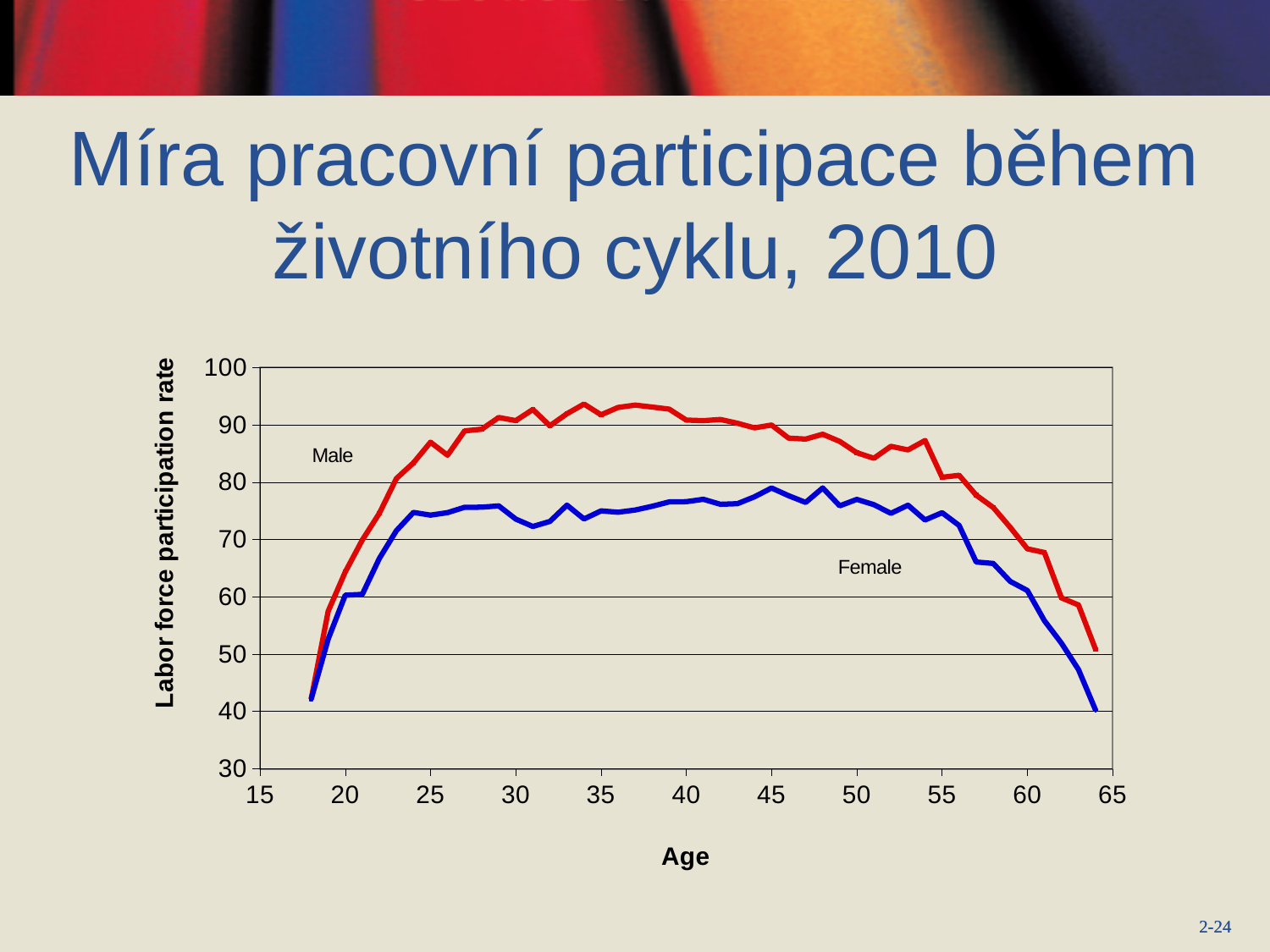
Does the Female series rise or fall between age 55 and age 64? fall What is the label of the x axis? Age How many series are plotted on the chart? 2 Is the value for Female at age 35 greater or less than 80? less Does the Male series rise or fall between age 18 and age 25? rise What is the label of the y axis? Labor force participation rate Which series is higher at age 40, Male or Female? Male Is the value for Female at age 62 greater or less than 60? less Is the value for Female at age 64 greater or less than 50? less What kind of chart is shown on the slide? line chart